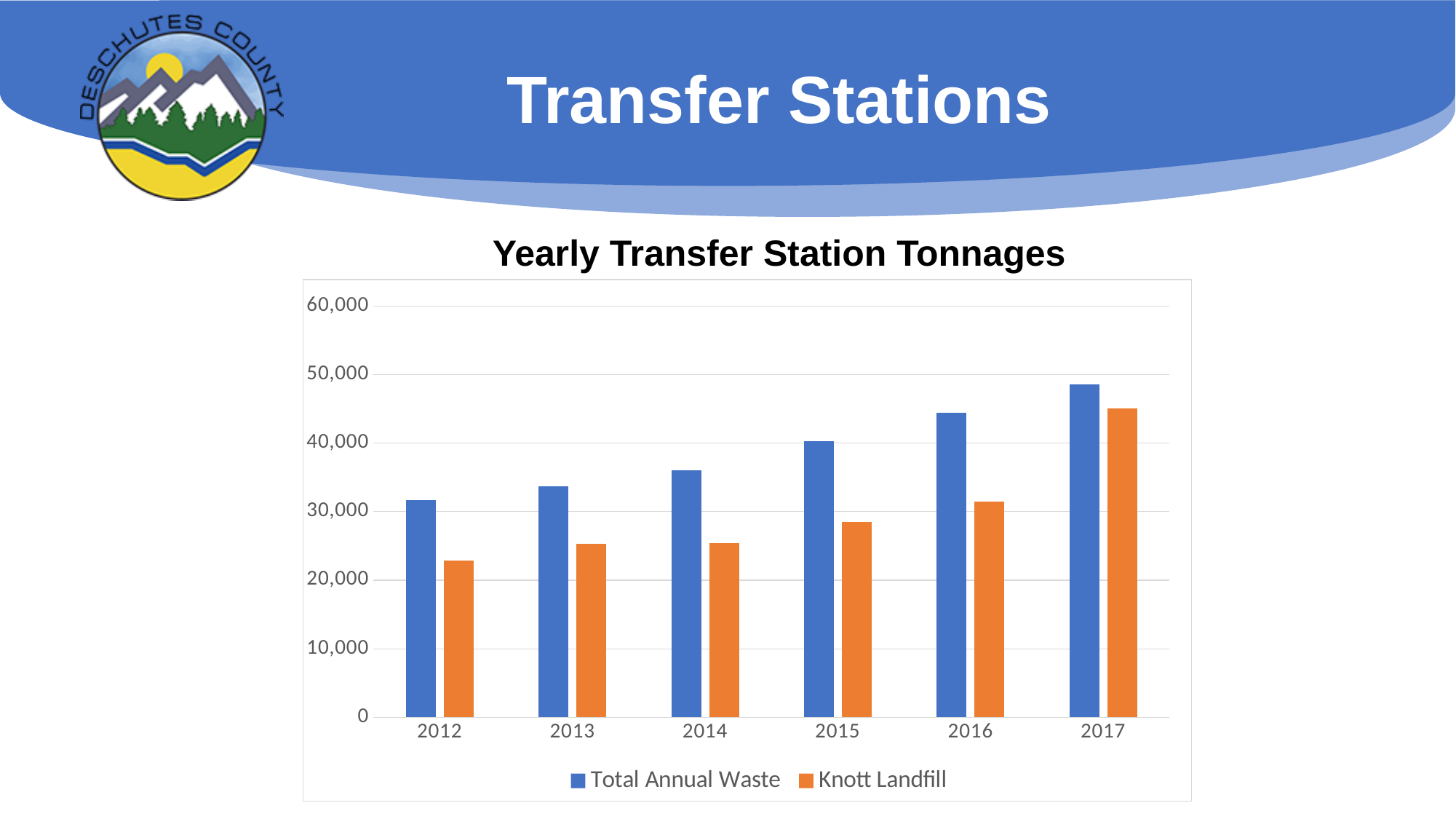
Do the Total Annual Waste values rise or fall from 2012 to 2017? rise What is the title of the chart? Yearly Transfer Station Tonnages How many series does the legend list? 2 Is the Total Annual Waste value for 2017 greater or less than 50,000? less In 2017, which is larger: Total Annual Waste or Knott Landfill? Total Annual Waste What type of chart is shown on the slide? bar chart In which year is Knott Landfill lowest? 2012 Which series is shown in orange? Knott Landfill Is the Knott Landfill value for 2015 greater or less than 30,000? less In which year is Total Annual Waste highest? 2017 How many years are shown on the x axis? 6 Is the Total Annual Waste value for 2012 greater or less than 30,000? greater